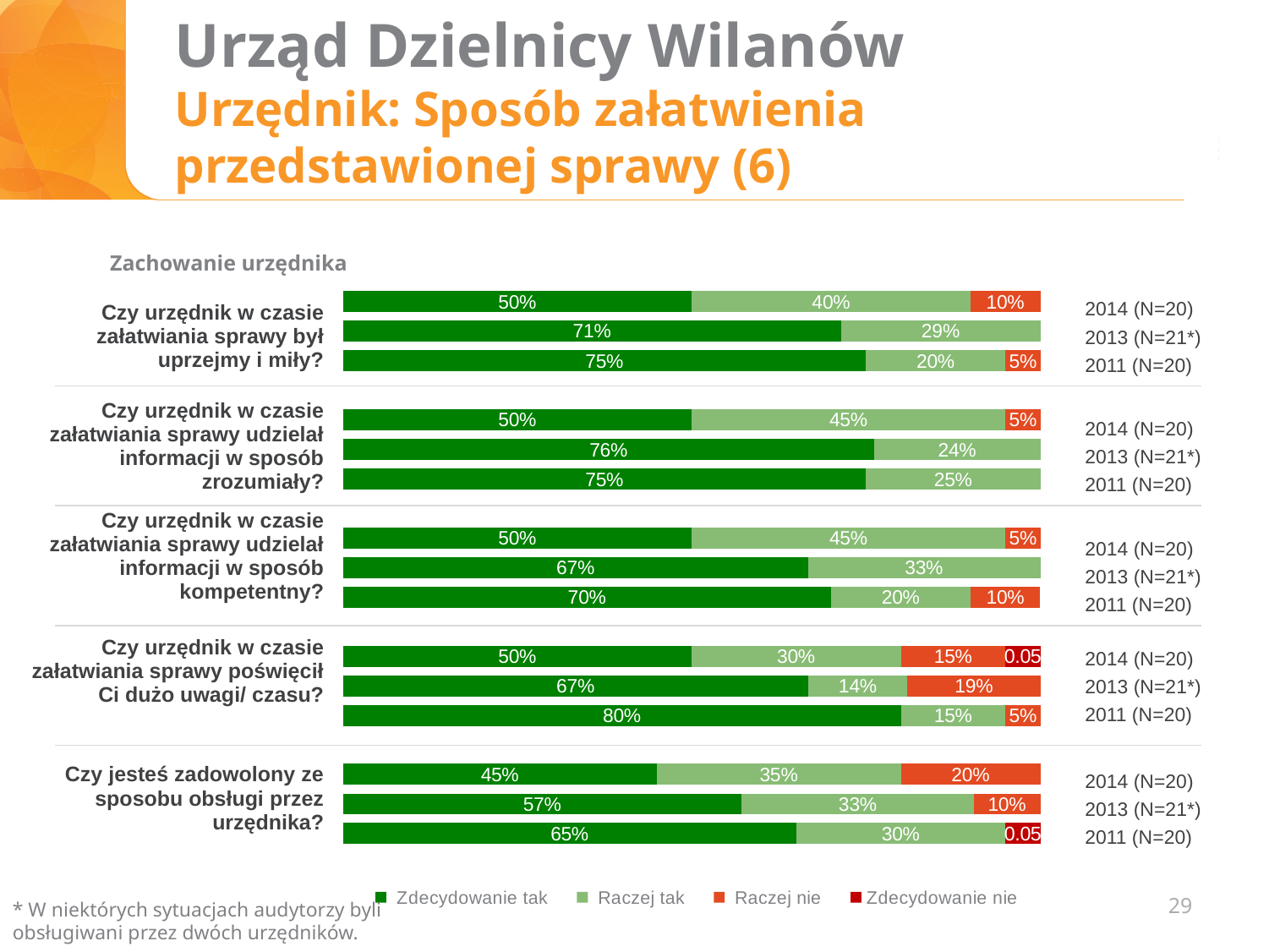
For "Czy jesteś zadowolony ze sposobu obsługi przez urzędnika?", did the "Zdecydowanie tak" share rise or fall from 2011 to 2014? Fall What kind of chart is shown on the slide? Stacked bar chart What percentage answered "Zdecydowanie tak" in 2014 to "Czy urzędnik w czasie załatwiania sprawy był uprzejmy i miły?"? 50% For "Czy urzędnik w czasie załatwiania sprawy udzielał informacji w sposób zrozumiały?", which year had the highest "Zdecydowanie tak" share? 2013 (76%) What is the "Raczej tak" value for 2013 in the question "Czy urzędnik w czasie załatwiania sprawy udzielał informacji w sposób zrozumiały?"? 24% Which question had the lowest "Zdecydowanie tak" share in 2014? Czy jesteś zadowolony ze sposobu obsługi przez urzędnika? (45%) In 2011, which had the larger "Zdecydowanie tak" share: "poświęcił Ci dużo uwagi/ czasu?" or "Czy jesteś zadowolony ze sposobu obsługi przez urzędnika?"? poświęcił Ci dużo uwagi/ czasu? (80%) What is the "Raczej nie" value for 2013 in "Czy urzędnik w czasie załatwiania sprawy poświęcił Ci dużo uwagi/ czasu?"? 19% What share answered "Zdecydowanie tak" in 2011 to "Czy urzędnik w czasie załatwiania sprawy poświęcił Ci dużo uwagi/ czasu?"? 80% What is the "Raczej nie" value for 2014 in "Czy jesteś zadowolony ze sposobu obsługi przez urzędnika?"? 20% For "Czy urzędnik w czasie załatwiania sprawy był uprzejmy i miły?", how much higher was the "Zdecydowanie tak" share in 2013 than in 2014? 21 percentage points How many series does the legend list? 4